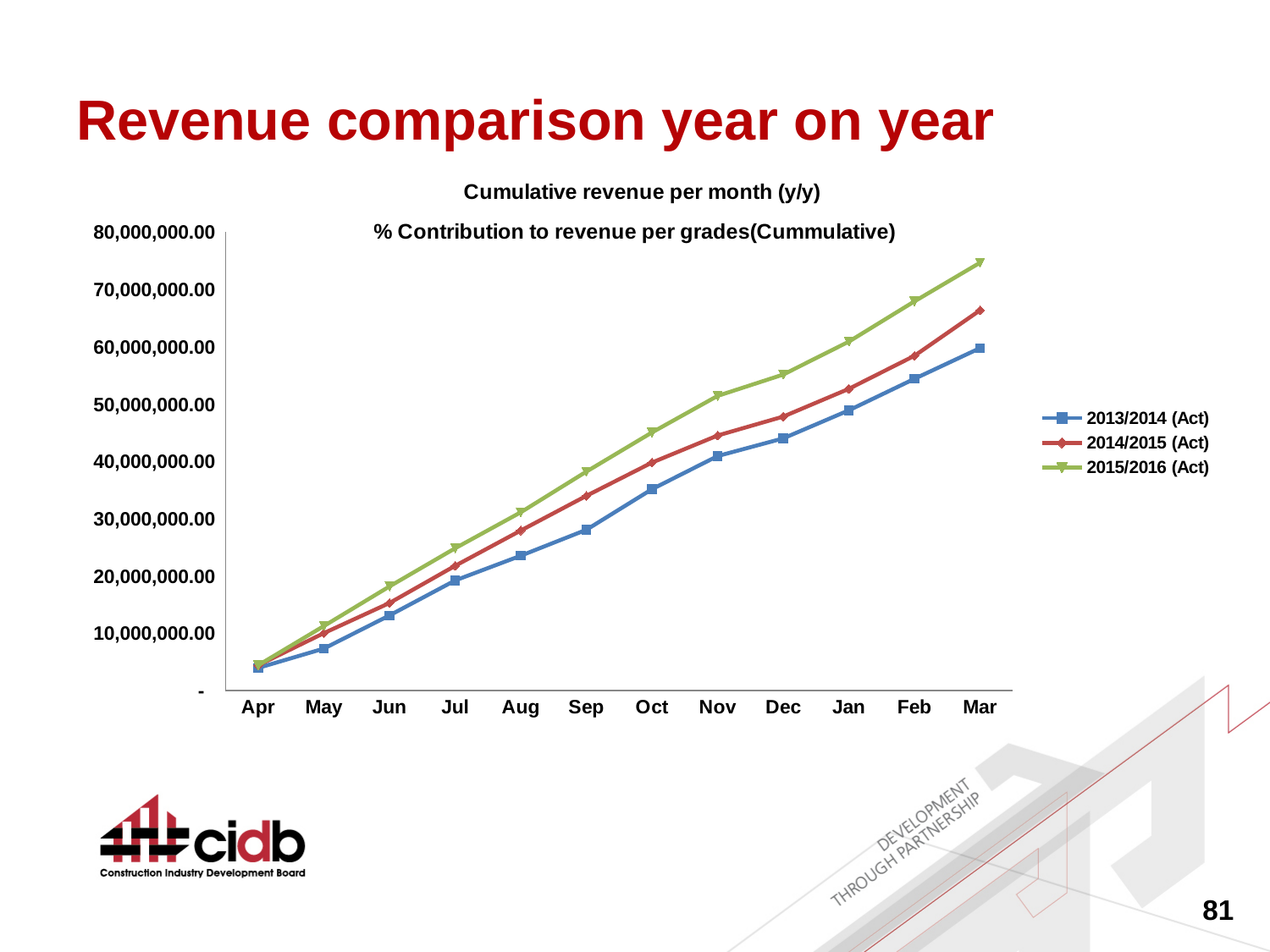
How many series does the legend list? 3 What kind of chart is shown on the slide? line chart Is the value for 2015/2016 (Act) in Mar greater or less than 70,000,000.00? greater Is the value for 2014/2015 (Act) in Sep greater or less than 30,000,000.00? greater Do the values for 2014/2015 (Act) rise or fall from Apr to Mar? rise Is the value for 2013/2014 (Act) in Oct greater or less than 40,000,000.00? less What is the title shown above the chart? Cumulative revenue per month (y/y) In Oct, which is larger: the value for 2015/2016 (Act) or the value for 2013/2014 (Act)? 2015/2016 (Act) How many months are shown along the x axis? 12 Which series has the highest value in Mar? 2015/2016 (Act) Which series has the lowest value in Dec? 2013/2014 (Act)